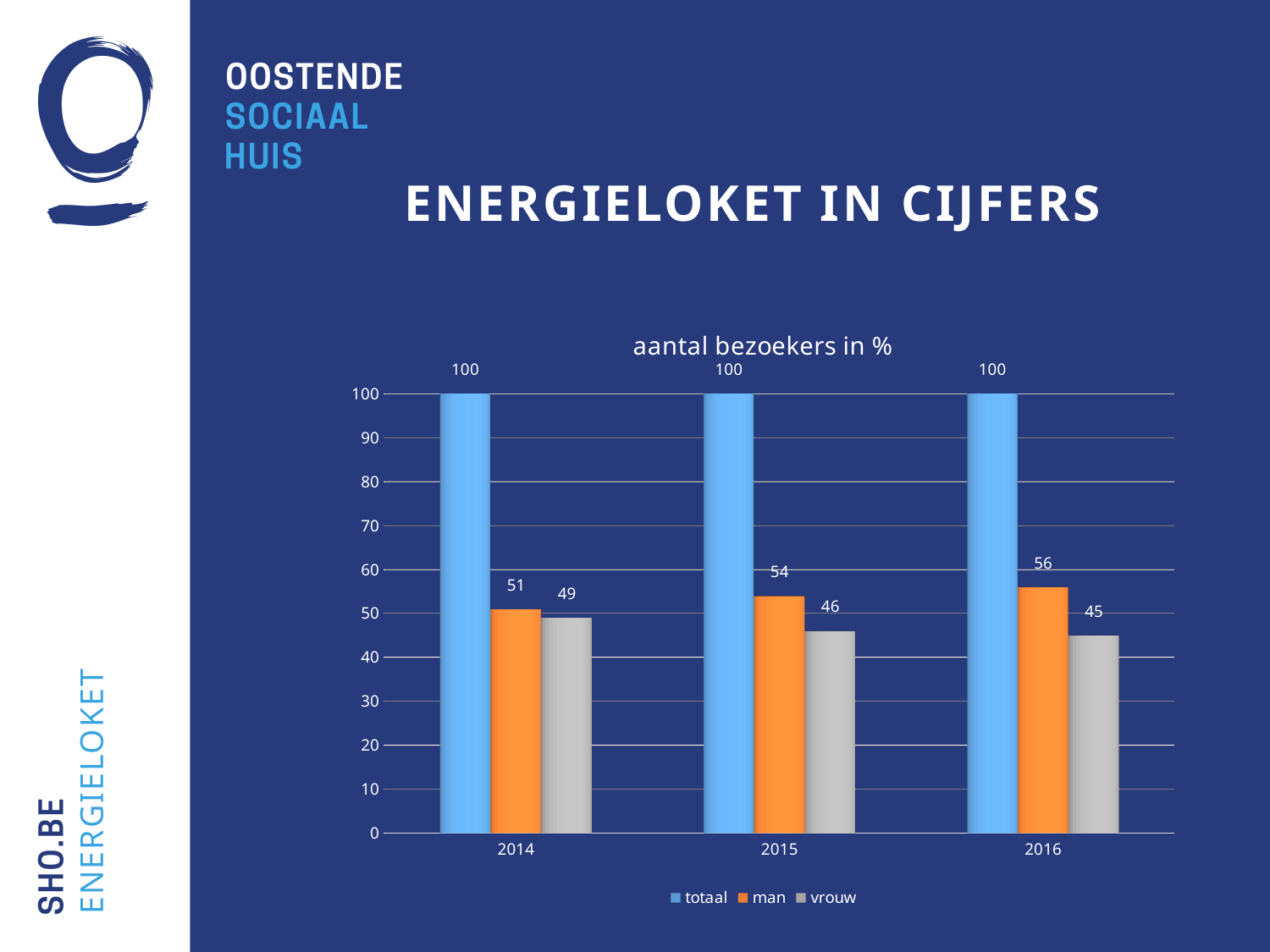
Does the 'vrouw' value rise or fall from 2014 to 2016? fall What is the title of the chart? aantal bezoekers in % In which year is the 'vrouw' value lowest? 2016 What is the value for 'vrouw' in 2016? 45 Which is larger in 2014, the 'man' value or the 'vrouw' value? man In which year is the 'man' value highest? 2016 What kind of chart is shown on the slide? bar chart How many years are shown on the x axis? 3 How many series does the legend list? 3 What is the value for 'totaal' in 2015? 100 What is the difference between the 'man' and 'vrouw' values in 2015? 8 What is the value for 'man' in 2014? 51